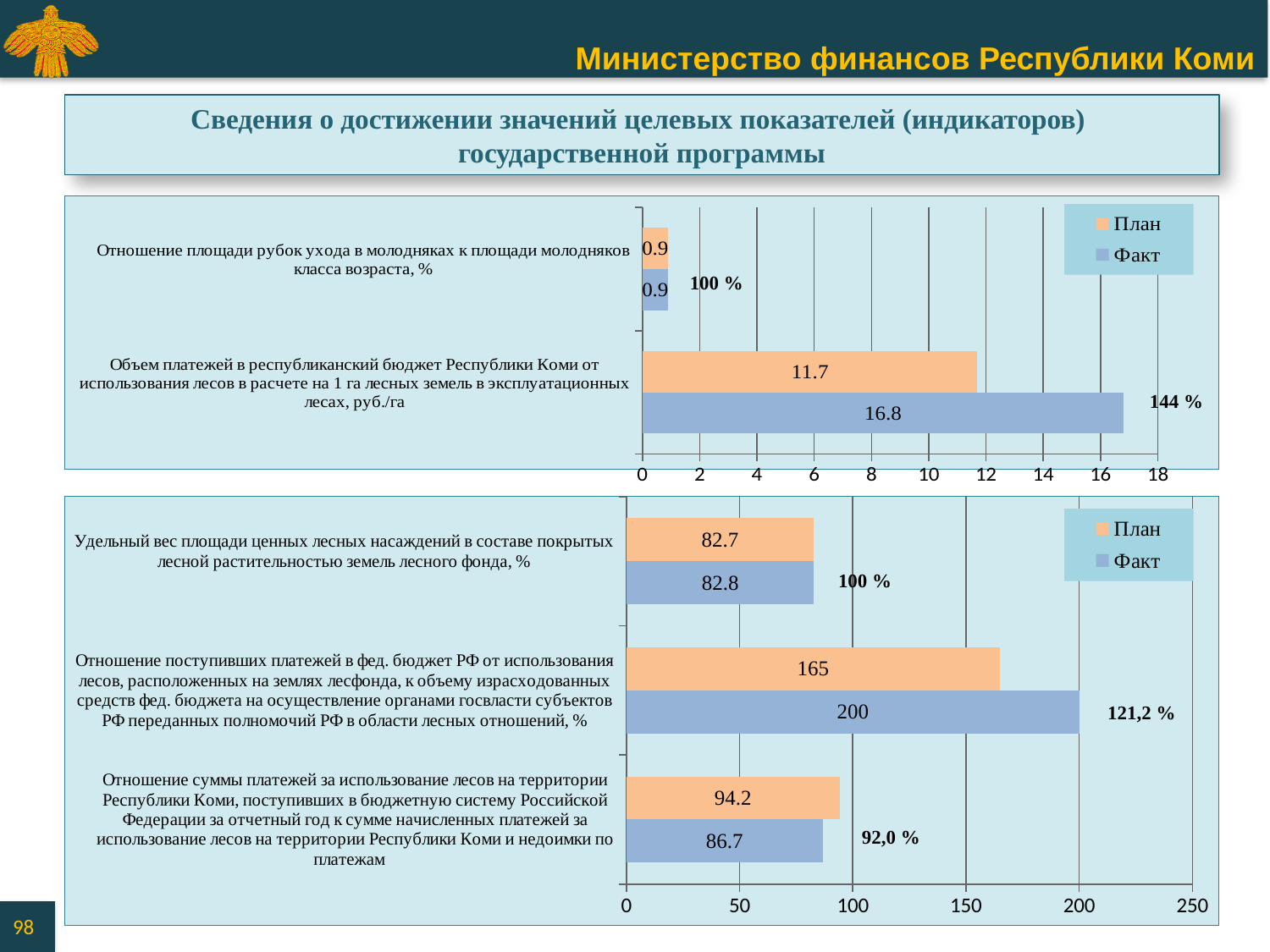
On the bottom chart, how many series does the legend list? 2 On the bottom chart, what is the difference between the План and Факт values for 'Отношение поступивших платежей в фед. бюджет РФ от использования лесов...'? 35 On the bottom chart, for 'Отношение суммы платежей за использование лесов на территории Республики Коми...', which is larger: the План value or the Факт value? План On the top chart, what is the План (plan) value for 'Объем платежей в республиканский бюджет Республики Коми от использования лесов в расчете на 1 га лесных земель в эксплуатационных лесах, руб./га'? 11.7 On the bottom chart, what is the План (plan) value for 'Отношение суммы платежей за использование лесов на территории Республики Коми, поступивших в бюджетную систему Российской Федерации за отчетный год...'? 94.2 On the top chart, what is the Факт (fact) value for 'Объем платежей в республиканский бюджет Республики Коми от использования лесов в расчете на 1 га лесных земель в эксплуатационных лесах, руб./га'? 16.8 On the top chart, how many categories are plotted? 2 On the bottom chart, what percentage label is shown next to the bars for 'Отношение суммы платежей за использование лесов на территории Республики Коми...'? 92,0 % On the top chart, what is the difference between the Факт and План values for 'Объем платежей в республиканский бюджет Республики Коми от использования лесов в расчете на 1 га лесных земель в эксплуатационных лесах, руб./га'? 5.1 On the bottom chart, what is the Факт (fact) value for 'Отношение поступивших платежей в фед. бюджет РФ от использования лесов, расположенных на землях лесфонда, к объему израсходованных средств фед. бюджета...'? 200 On the top chart, what kind of chart is shown? Bar chart